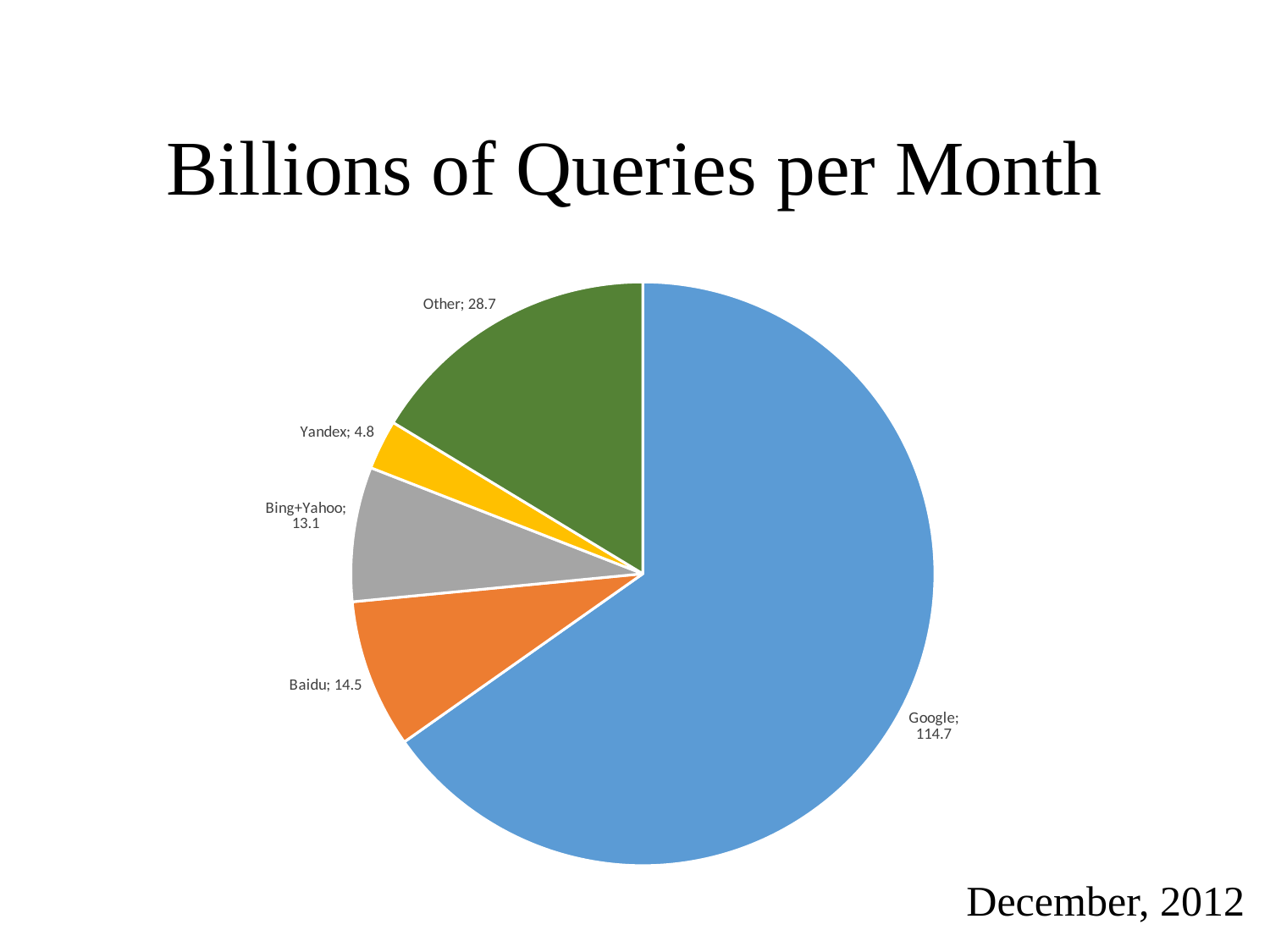
How many slices does the pie chart have? 5 Which category has the largest slice? Google Which is larger, the value for Baidu or the value for Bing+Yahoo? Baidu What is the value for Bing+Yahoo? 13.1 What is the title of the chart? Billions of Queries per Month What is the value for Baidu? 14.5 What is the value for Yandex? 4.8 What is the value for Google? 114.7 Which category has the smallest slice? Yandex What is the value for Other? 28.7 What is the difference between the values for Google and Other? 86.0 What type of chart is shown on the slide? pie chart